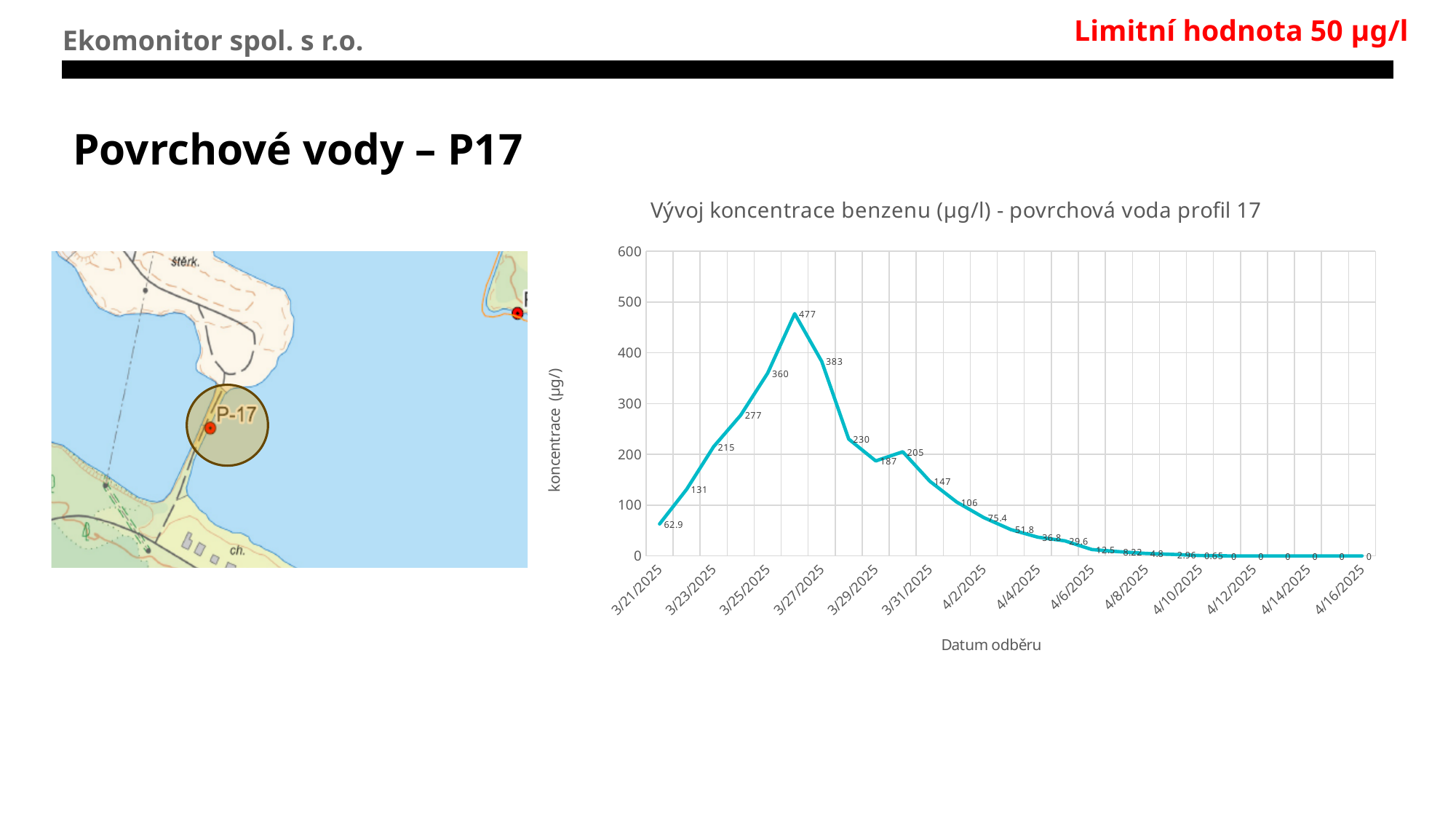
What is the title of the chart? Vývoj koncentrace benzenu (µg/l) - povrchová voda profil 17 What is the benzene concentration on 3/23/2025? 215 After the peak, do the benzene concentration values rise or fall toward 4/16/2025? fall What is the highest benzene concentration value plotted on the chart? 477 What type of chart is shown on the slide? line chart What is the benzene concentration on 3/27/2025? 383 Is the benzene concentration on 3/25/2025 greater or less than 300? greater What is the benzene concentration on 4/10/2025? 0.65 Which date has the higher benzene concentration, 3/23/2025 or 3/29/2025? 3/23/2025 What is the benzene concentration on 4/2/2025? 75.4 What is the difference between the peak value of 477 and the following value of 383? 94 What is the benzene concentration on 3/21/2025? 62.9